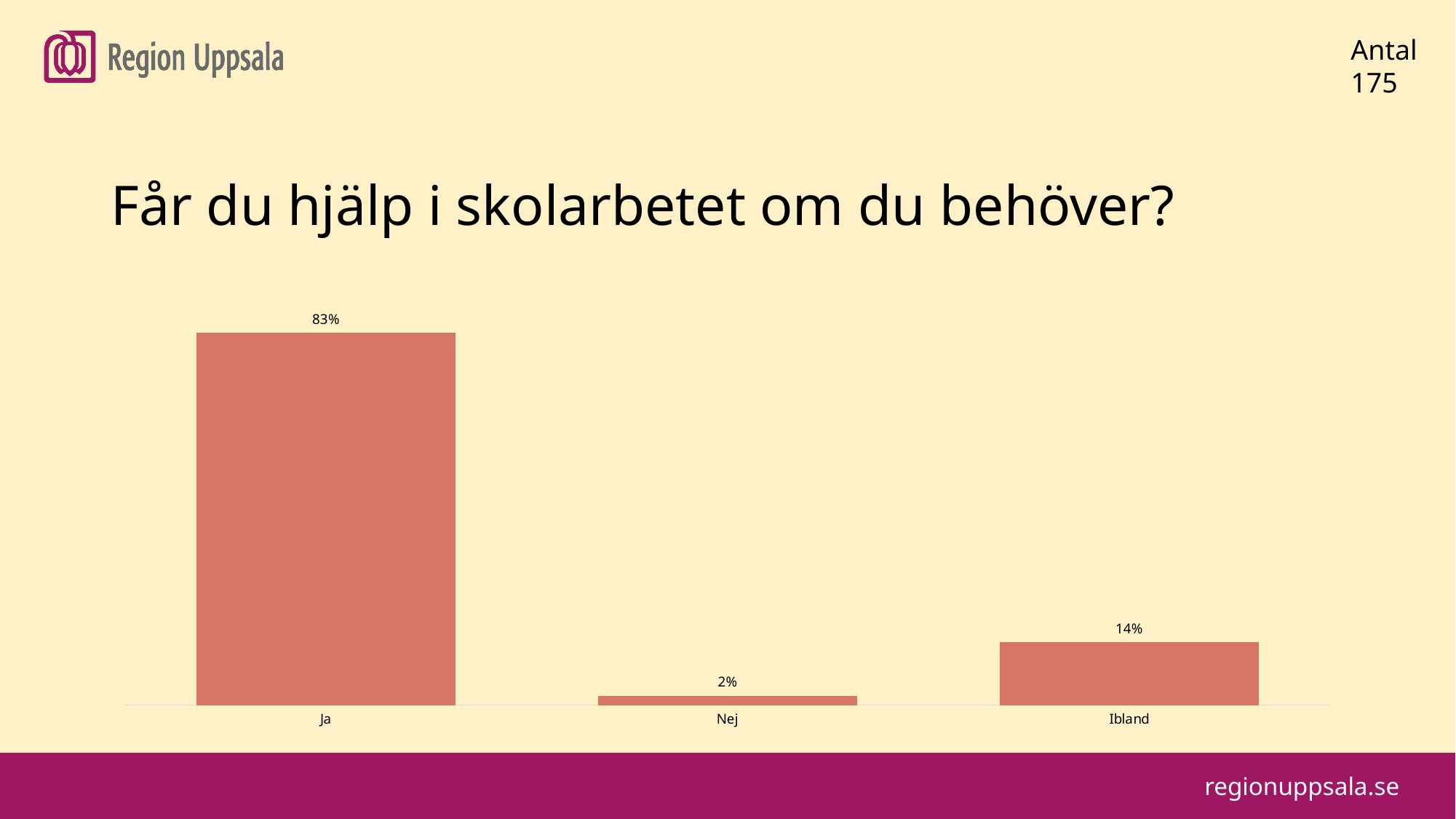
What is the value for Ja? 83% Which is larger, the value for Ibland or the value for Nej? Ibland How many categories are shown on the x axis? 3 What kind of chart is shown on the slide? Bar chart What is the difference between the values for Ja and Ibland? 69% What is the value for Nej? 2% Which category has the highest value? Ja Which category has the lowest value? Nej What is the value for Ibland? 14% What is the number shown under "Antal" in the top right corner? 175 What is the title of the slide above the chart? Får du hjälp i skolarbetet om du behöver? What is the difference between the values for Ibland and Nej? 12%